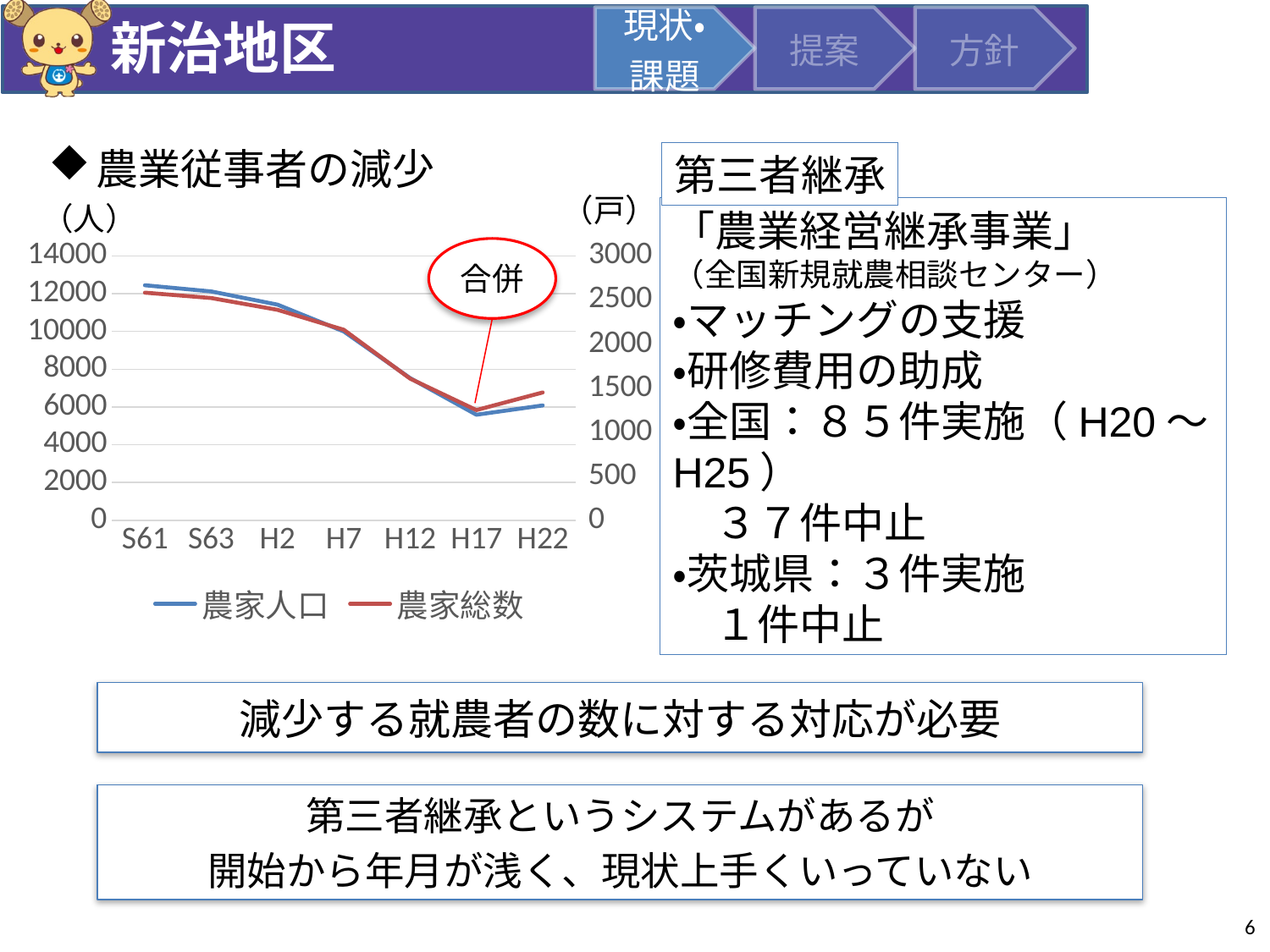
What annotation label is attached to the chart near H17? 合併 In which year is the 農家人口 value highest? S61 How many series does the chart legend list? 2 How many points are plotted along the x axis of the chart? 7 Is the 農家人口 value for H12 greater or less than 8000? less Is the 農家人口 value for H17 greater or less than 6000? less What kind of chart is shown on the slide? line chart Does the 農家人口 line rise or fall from S61 to H17? fall Is the 農家人口 value for S61 greater or less than 12000? greater In which year is the 農家人口 value lowest? H17 Which series are listed in the chart legend? 農家人口 and 農家総数